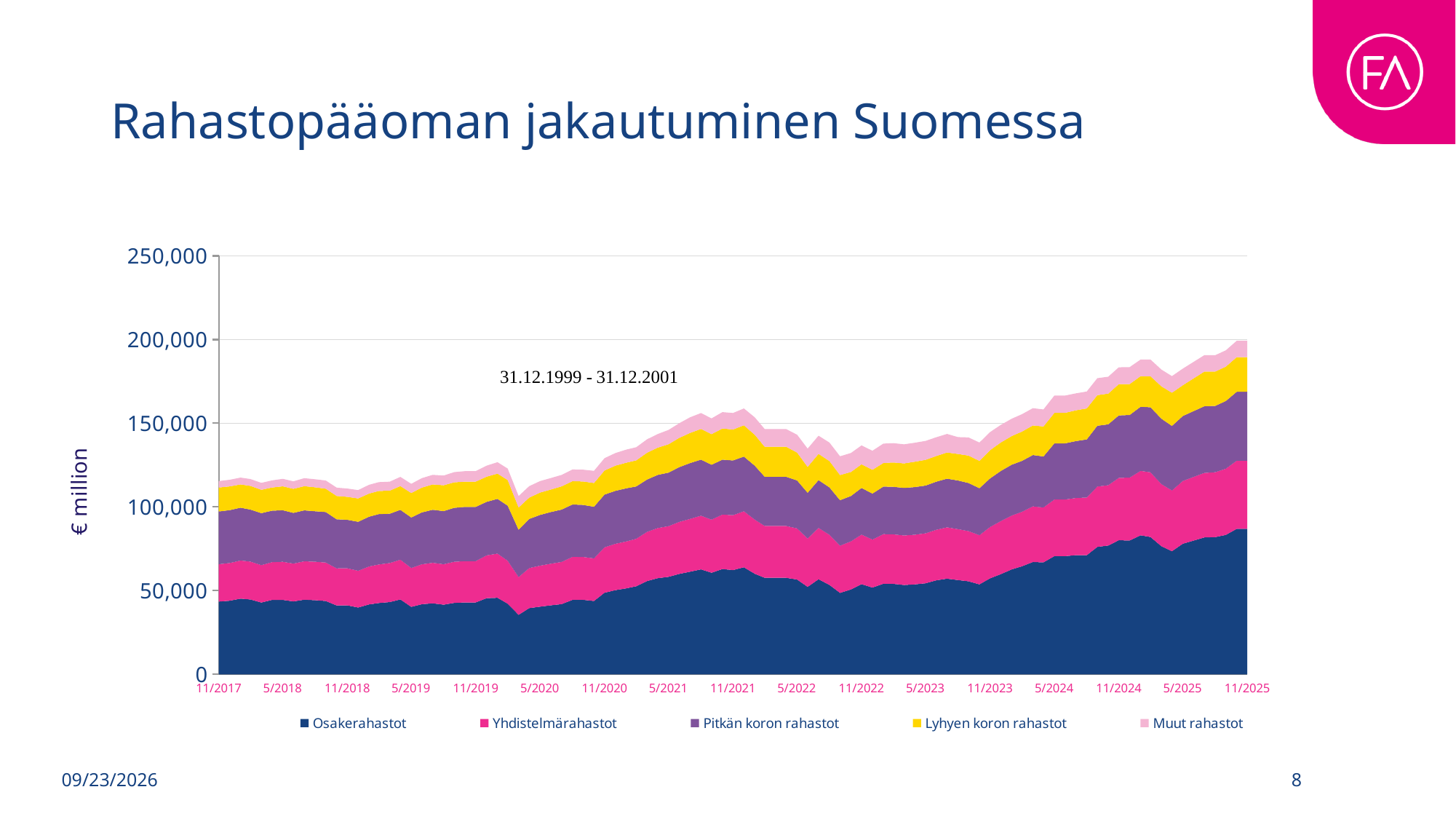
Is the total stacked value at 5/2020 greater or less than 150,000? less Does the total fund capital generally rise or fall from 11/2017 to 11/2025? rise Which series has the smallest value at 11/2025? Muut rahastot How many series does the legend list? 5 What is the title of the chart? Rahastopääoman jakautuminen Suomessa Which series has the largest value at 11/2025? Osakerahastot What kind of chart is shown on the slide? Stacked area chart What is the label on the vertical axis? € million At 11/2025, which is larger: Osakerahastot or Yhdistelmärahastot? Osakerahastot Is the total stacked value at 11/2017 greater or less than 100,000? greater Is the total stacked value at 11/2025 greater or less than 150,000? greater